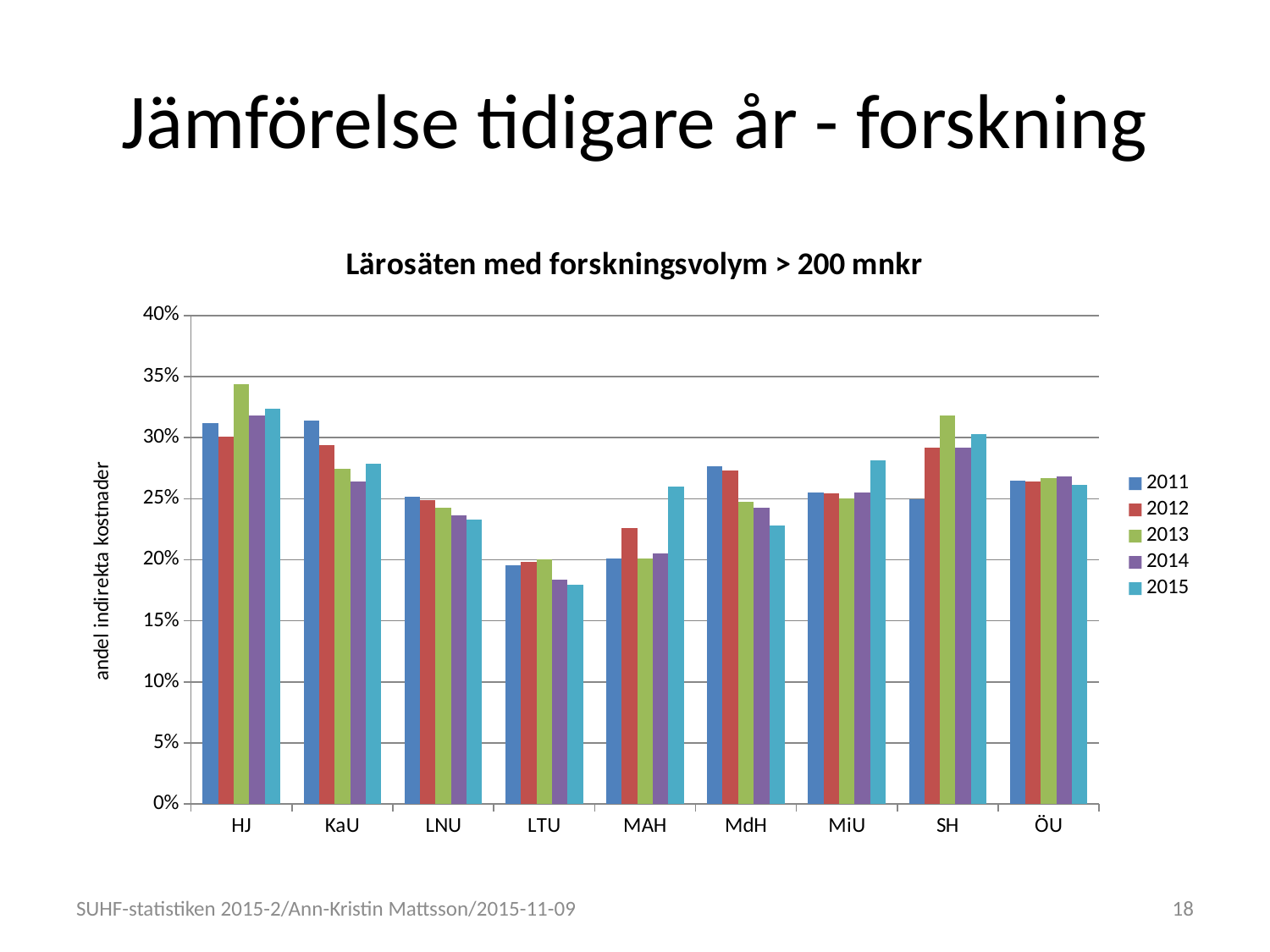
How many institutions (categories) are shown on the x axis? 9 For HJ, which year has the highest value? 2013 Is the value for LTU in 2015 greater or less than 20%? less Which is larger: the 2013 value for HJ or the 2013 value for KaU? HJ For MAH, which year has the highest value? 2015 Is the value for HJ in 2013 greater or less than 30%? greater How many series does the legend list? 5 What is the title of the chart? Lärosäten med forskningsvolym > 200 mnkr For SH, which year has the highest value? 2013 What is the label on the vertical axis? andel indirekta kostnader What kind of chart is shown on the slide? bar chart Do the values for LNU rise or fall from 2011 to 2015? fall